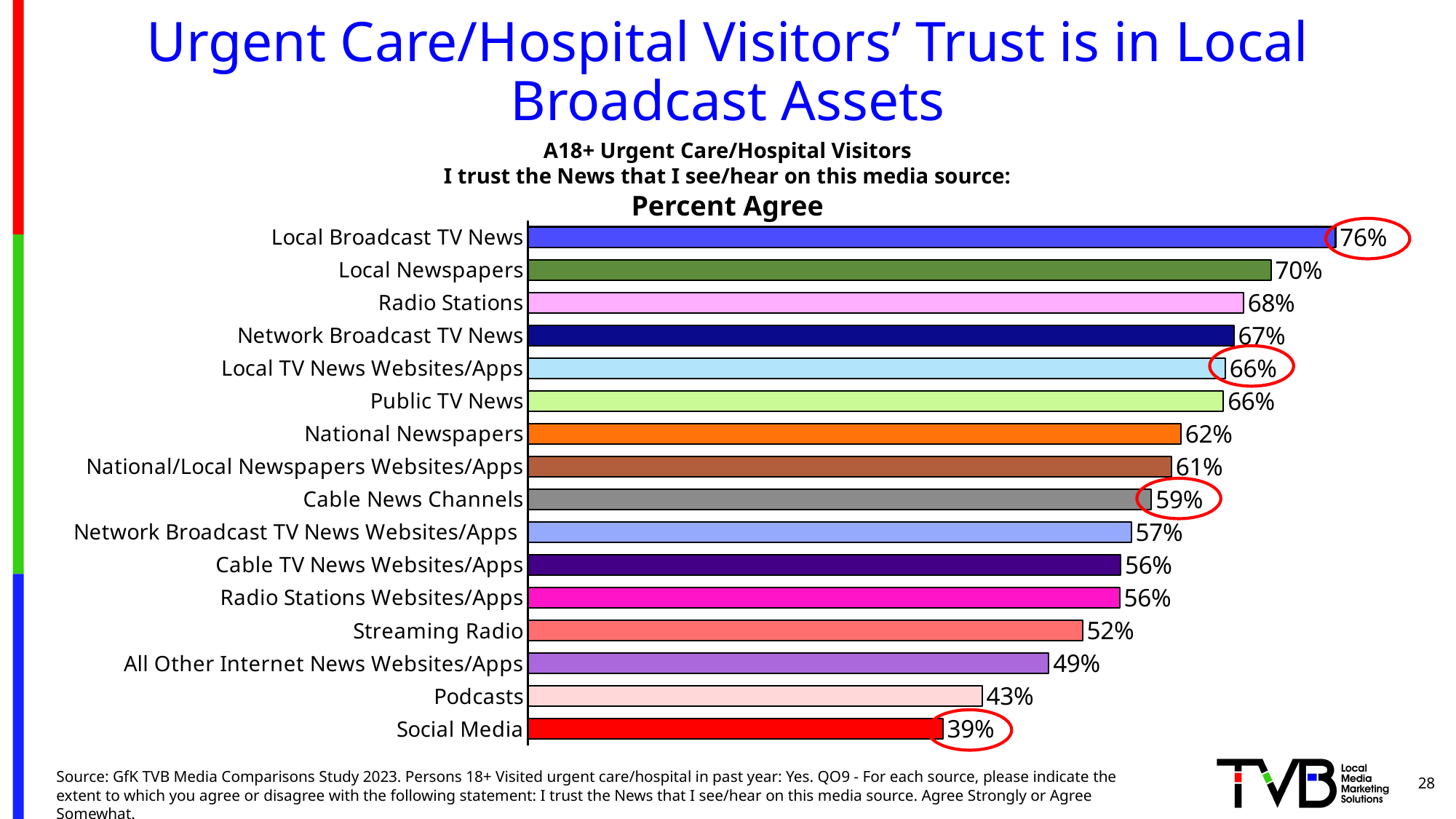
What is the percent agree value for Local TV News Websites/Apps? 66% Which has a higher percent agree, Radio Stations or Streaming Radio? Radio Stations Which media source has the lowest percent agree? Social Media What is the percent agree value for Podcasts? 43% How many media sources are shown in the chart? 16 What is the difference in percent agree between Local Newspapers and Cable News Channels? 11% What kind of chart is shown on the slide? Bar chart Which has a higher percent agree, National Newspapers or Network Broadcast TV News Websites/Apps? National Newspapers What is the difference in percent agree between Local Broadcast TV News and Social Media? 37% What is the percent agree value for Cable News Channels? 59% Which media source has the highest percent agree? Local Broadcast TV News What percent of urgent care/hospital visitors agree they trust the news on Local Broadcast TV News? 76%